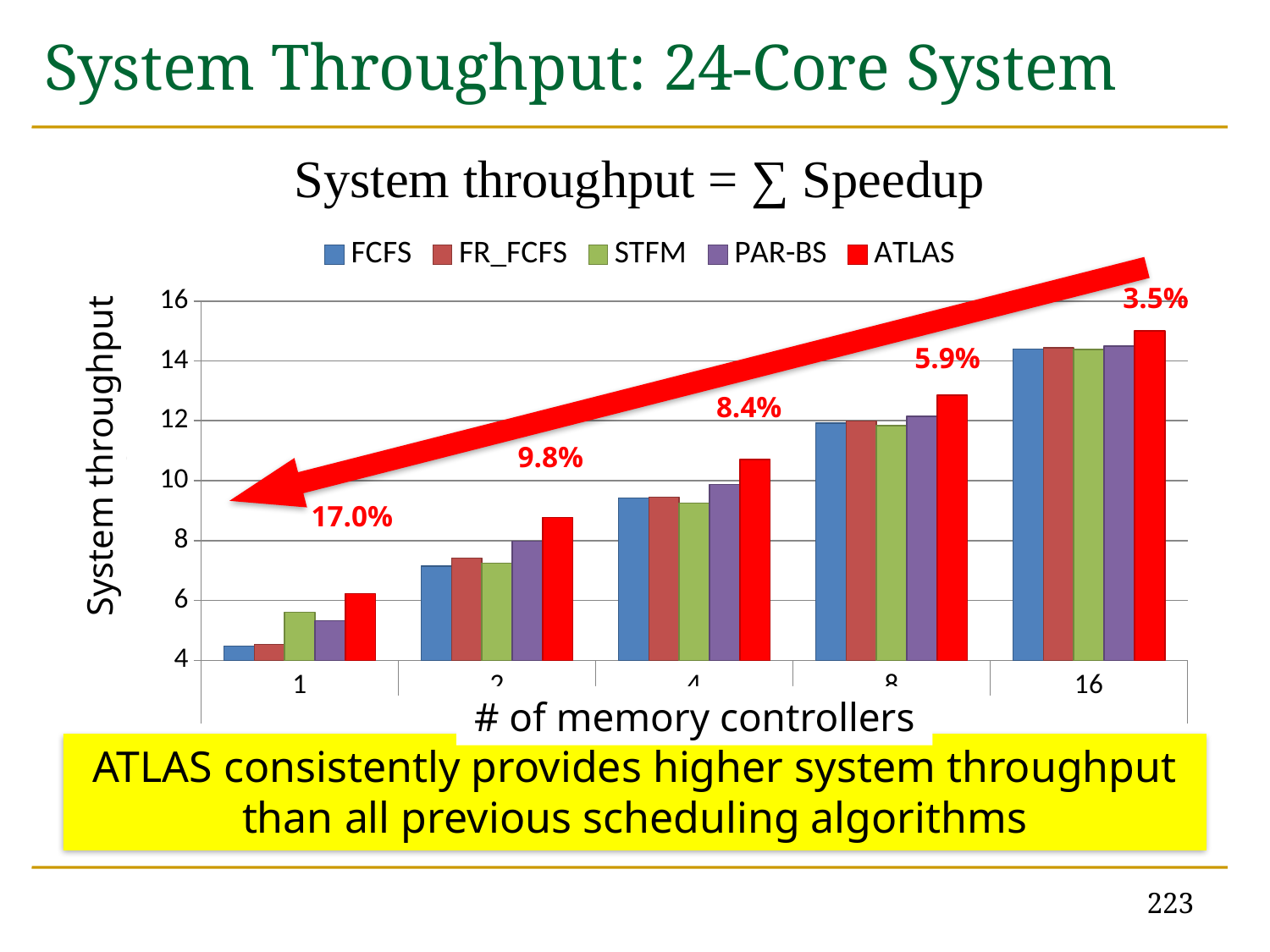
Do the system throughput values rise or fall as the number of memory controllers increases? rise How many series does the legend list? 5 Is the ATLAS value for 8 memory controllers greater or less than 12? greater What percentage label is printed above the bars for 1 memory controller? 17.0% For 16 memory controllers, which is larger: the FCFS value or the ATLAS value? ATLAS What is the label of the x axis? # of memory controllers Is the FCFS value for 1 memory controller greater or less than 6? less What kind of chart is shown on the slide? bar chart Which series has the highest system throughput for 16 memory controllers? ATLAS How many groups of bars (categories) are plotted along the x axis? 5 Which series has the highest system throughput for 1 memory controller? ATLAS Is the ATLAS value for 16 memory controllers greater or less than 14? greater